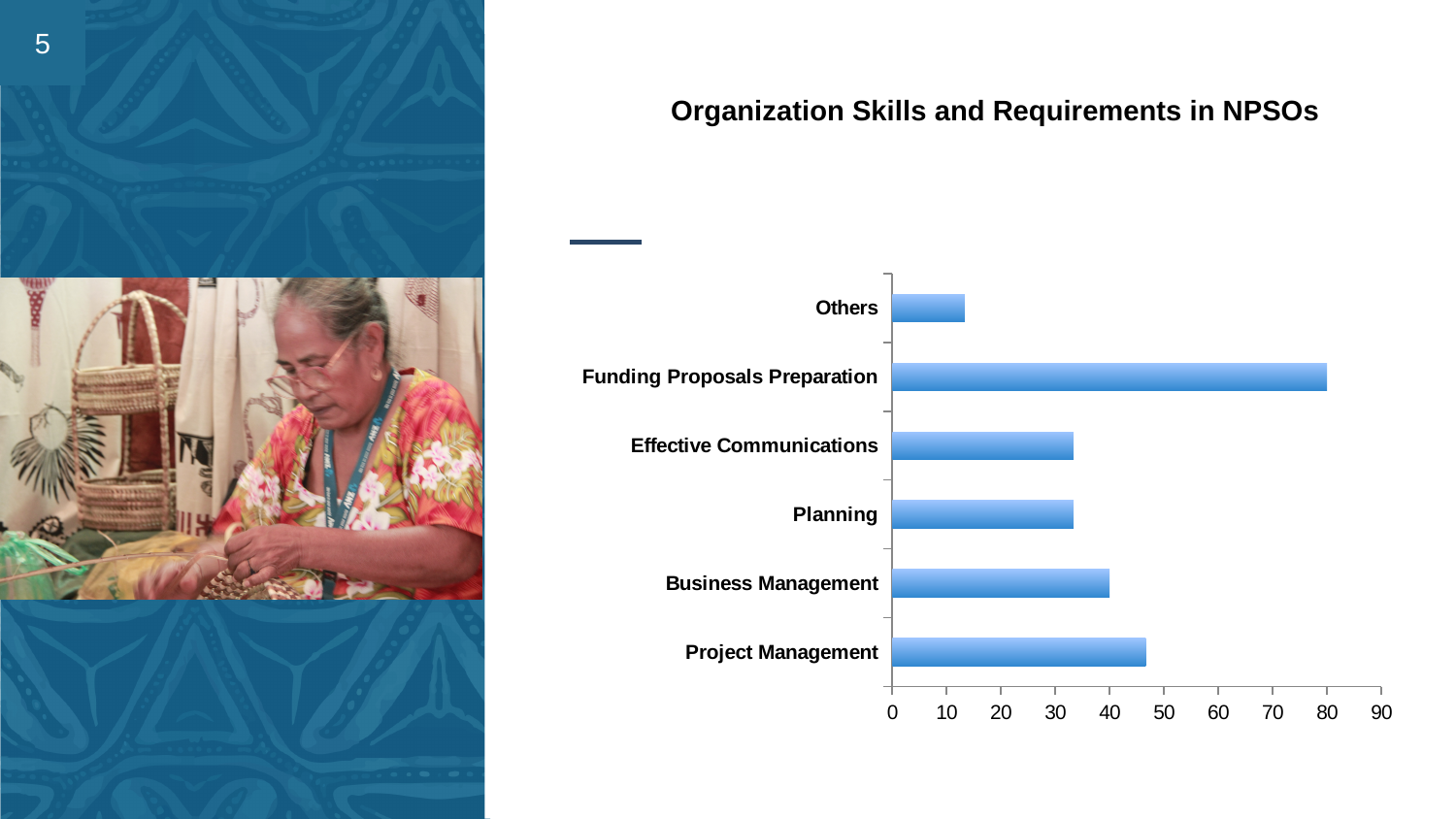
Is the value for Funding Proposals Preparation greater or less than 70? greater What kind of chart is shown on the slide? bar chart Is the value for Project Management greater or less than 40? greater What is the title of the chart? Organization Skills and Requirements in NPSOs What is the highest value shown on the horizontal axis? 90 Is the value for Effective Communications greater or less than 30? greater Which is larger, the value for Project Management or the value for Business Management? Project Management Which category has the lowest value? Others Which category has the highest value? Funding Proposals Preparation How many categories are plotted in the chart? 6